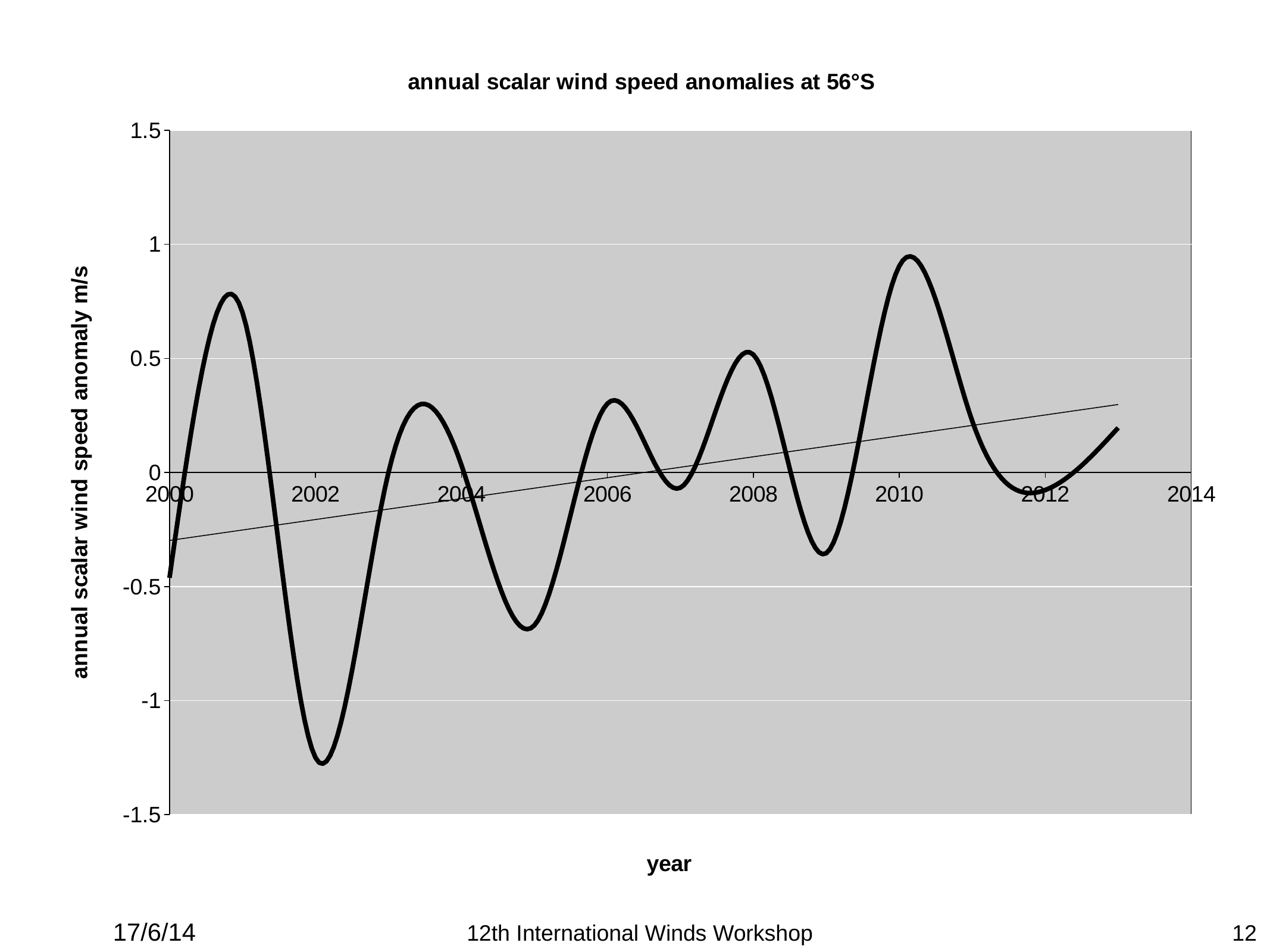
Is the value for 2002 greater or less than -1? less What is the title of the chart? annual scalar wind speed anomalies at 56°S In which year does the wind speed anomaly reach its highest value? 2010 Is the value for 2009 greater or less than 0? less Which is larger, the anomaly in 2001 or the anomaly in 2006? 2001 Is the value for 2010 greater or less than 0.5? greater What is the label of the x axis? year What kind of chart is shown on the slide? line chart In which year does the wind speed anomaly reach its lowest value? 2002 Does the thin straight trend line rise or fall from 2000 to 2013? rise